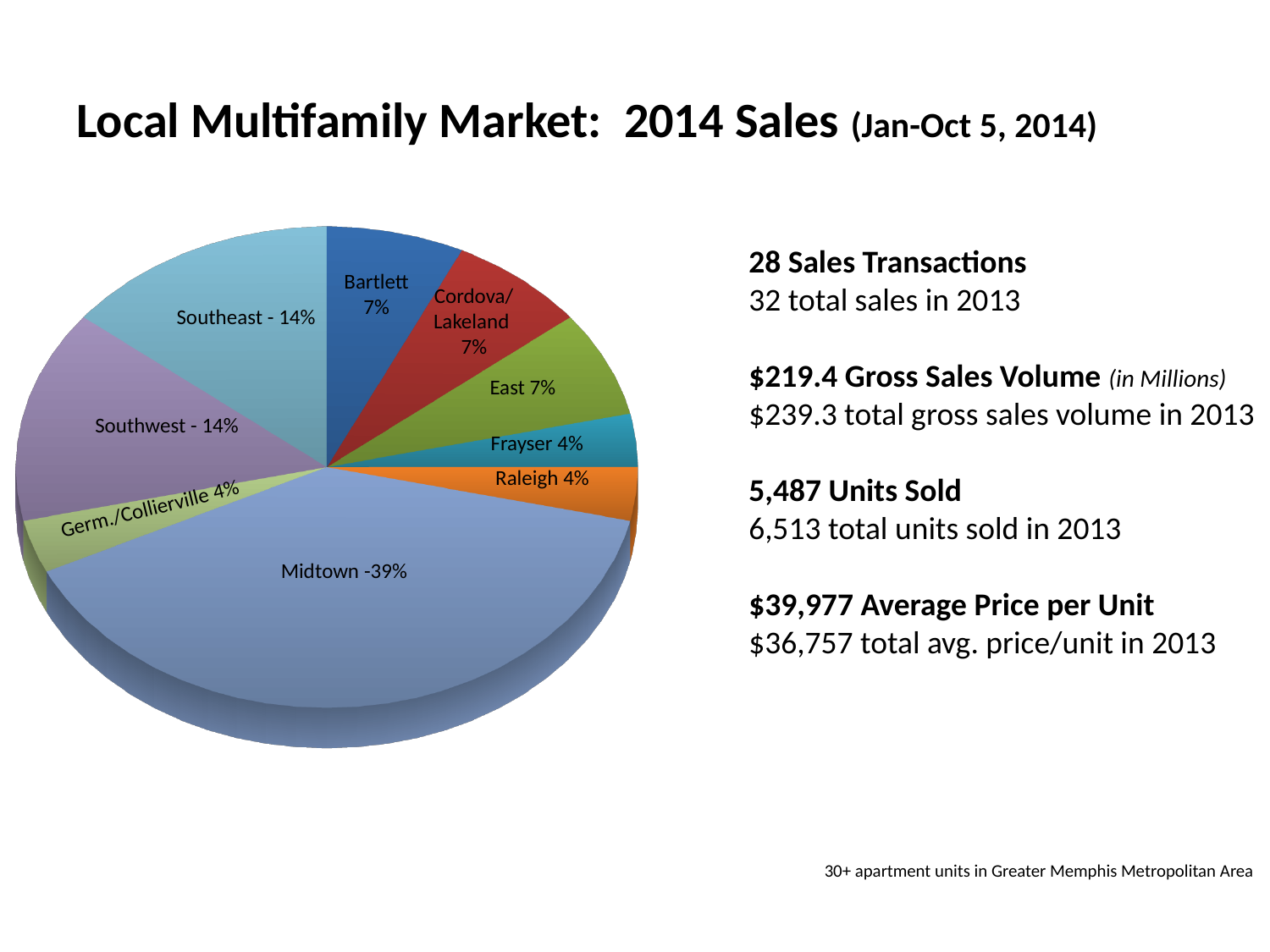
What share of the pie does Midtown represent? 39% What is the title of the slide containing the pie chart? Local Multifamily Market: 2014 Sales (Jan-Oct 5, 2014) How many slices are labeled 4%? 3 What percentage is shown for Cordova/Lakeland? 7% How many slices does the pie chart have? 9 What is the combined share of Southeast and Southwest? 28% Which slice of the pie is the largest? Midtown Which is larger, the share for East or the share for Raleigh? East What kind of chart is shown on the slide? pie chart What percentage is shown for Southeast? 14% What is the difference in percentage points between Midtown and Southwest? 25 What percentage is shown for Frayser? 4%